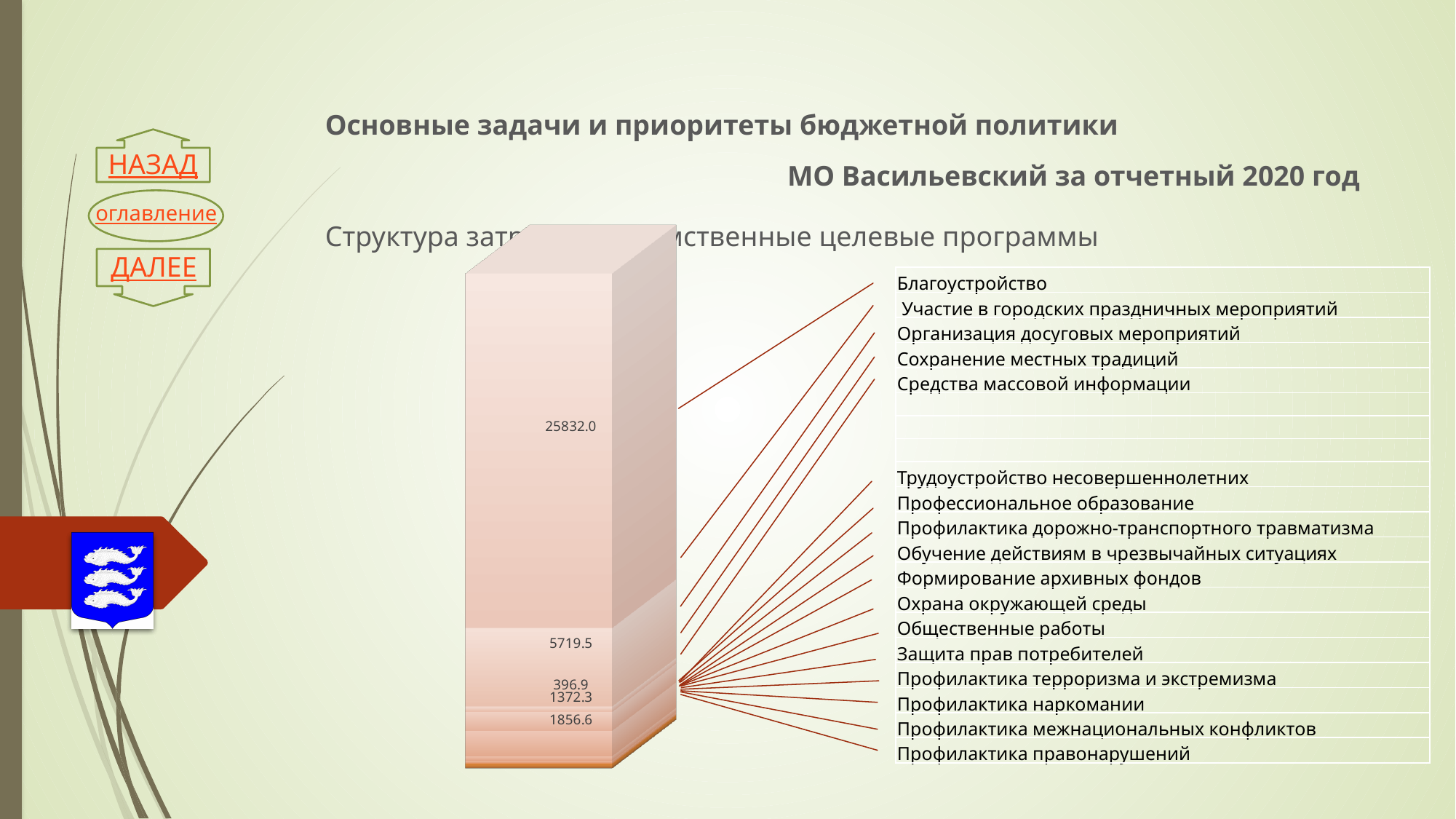
What is the difference between the segment labelled 1856.6 and the segment labelled 1372.3? 484.3 Which is larger: the segment labelled 5719.5 or the segment labelled 1856.6? 5719.5 What is the smallest value printed on the bar? 396.9 What is the value of the largest labelled segment of the bar? 25832.0 What is the difference between the segment labelled 25832.0 and the segment labelled 5719.5? 20112.5 How many data labels are printed on the bar? 5 How many category labels are listed to the right of the bar? 17 What is the value of the second-largest labelled segment of the bar? 5719.5 What kind of chart is shown on the slide? Stacked bar chart What is the value printed on the bottom labelled segment of the bar? 1856.6 Which category label appears first (at the top) in the list to the right of the bar? Благоустройство